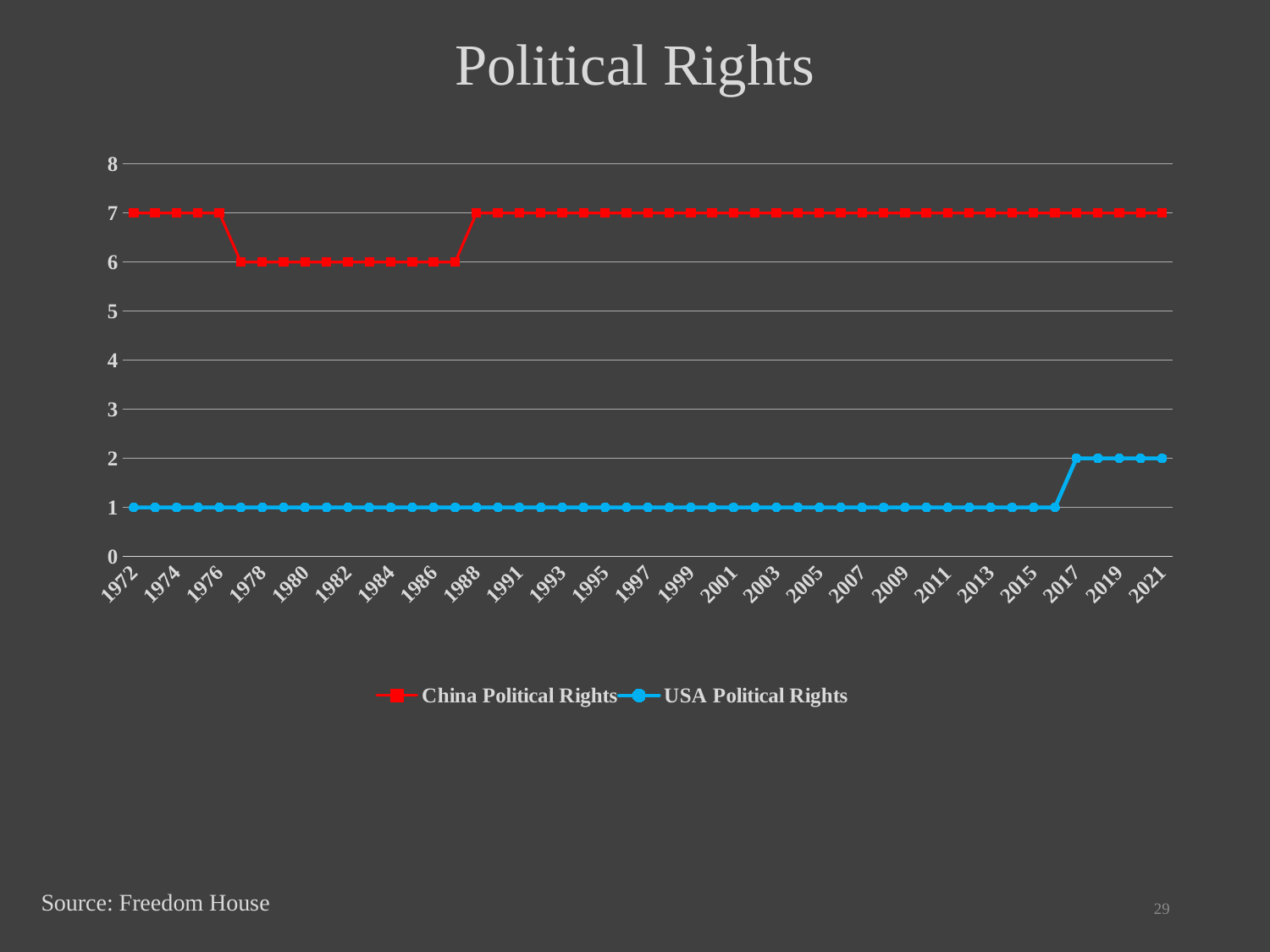
What is the USA Political Rights value in 1995? 1 What is the difference between the China Political Rights and USA Political Rights values in 1980? 5 In 2021, which series has the higher value, China Political Rights or USA Political Rights? China Political Rights Does the USA Political Rights series rise or fall from 2015 to 2021? rise What is the difference between the China Political Rights and USA Political Rights values in 2021? 5 What is the China Political Rights value in 2010? 7 What colour is the USA Political Rights line? blue What is the USA Political Rights value in 2019? 2 What is the lowest value reached by the China Political Rights series? 6 How many series does the legend list? 2 What kind of chart is shown on the slide? line chart What is the China Political Rights value in 1980? 6